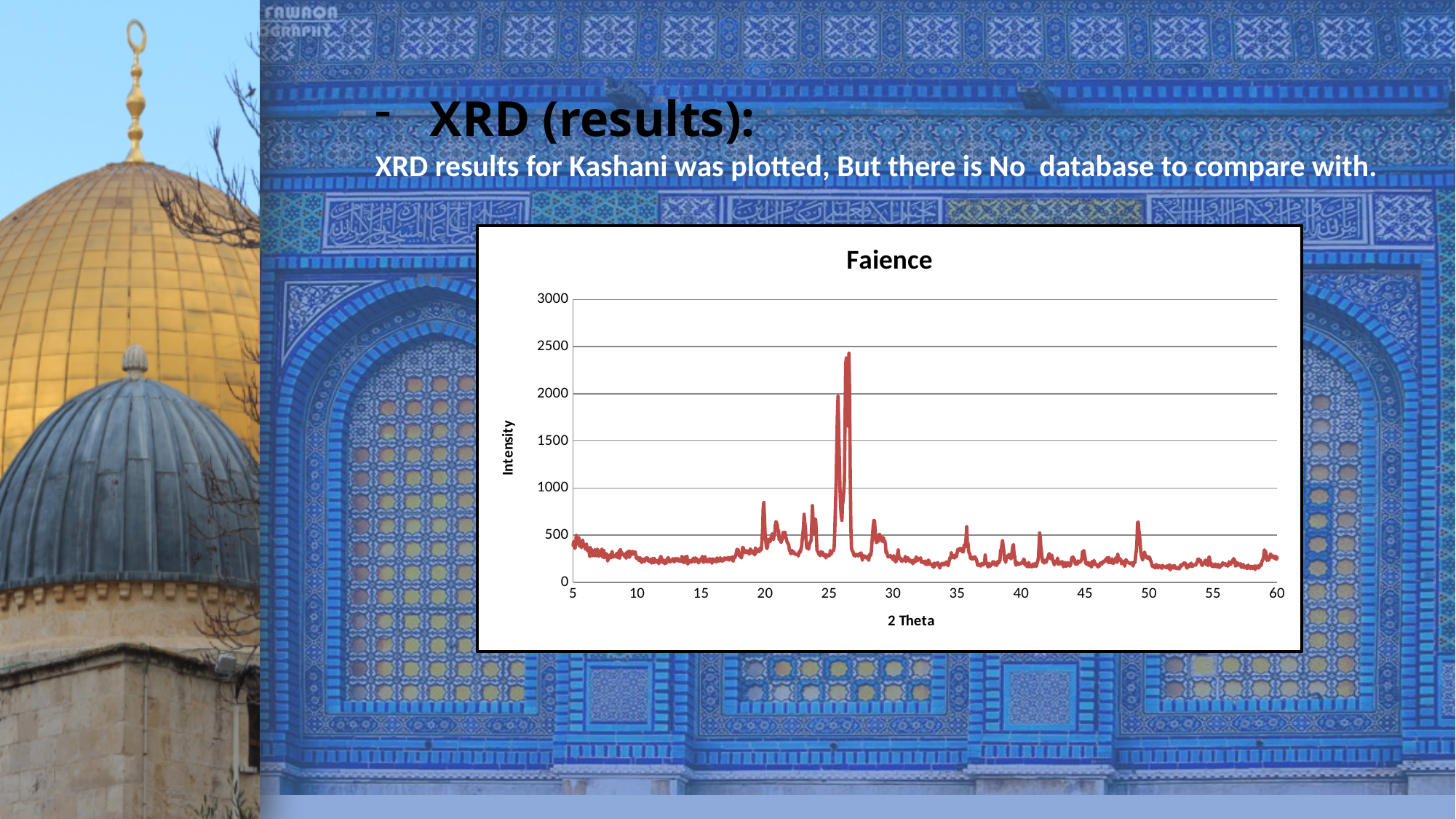
What is the highest tick value shown on the y axis (Intensity)? 3000 Is the intensity at 2 Theta = 15 greater or less than 1000? less How many data series are plotted in the chart? 1 What is the highest tick value shown on the x axis (2 Theta)? 60 What is the label of the x axis of the chart? 2 Theta Is the maximum intensity reached by the line greater or less than 2500? less Is the intensity at 2 Theta = 60 greater or less than 500? less What is the lowest tick value shown on the x axis (2 Theta)? 5 What kind of chart is shown on the slide? line chart What is the title of the chart? Faience